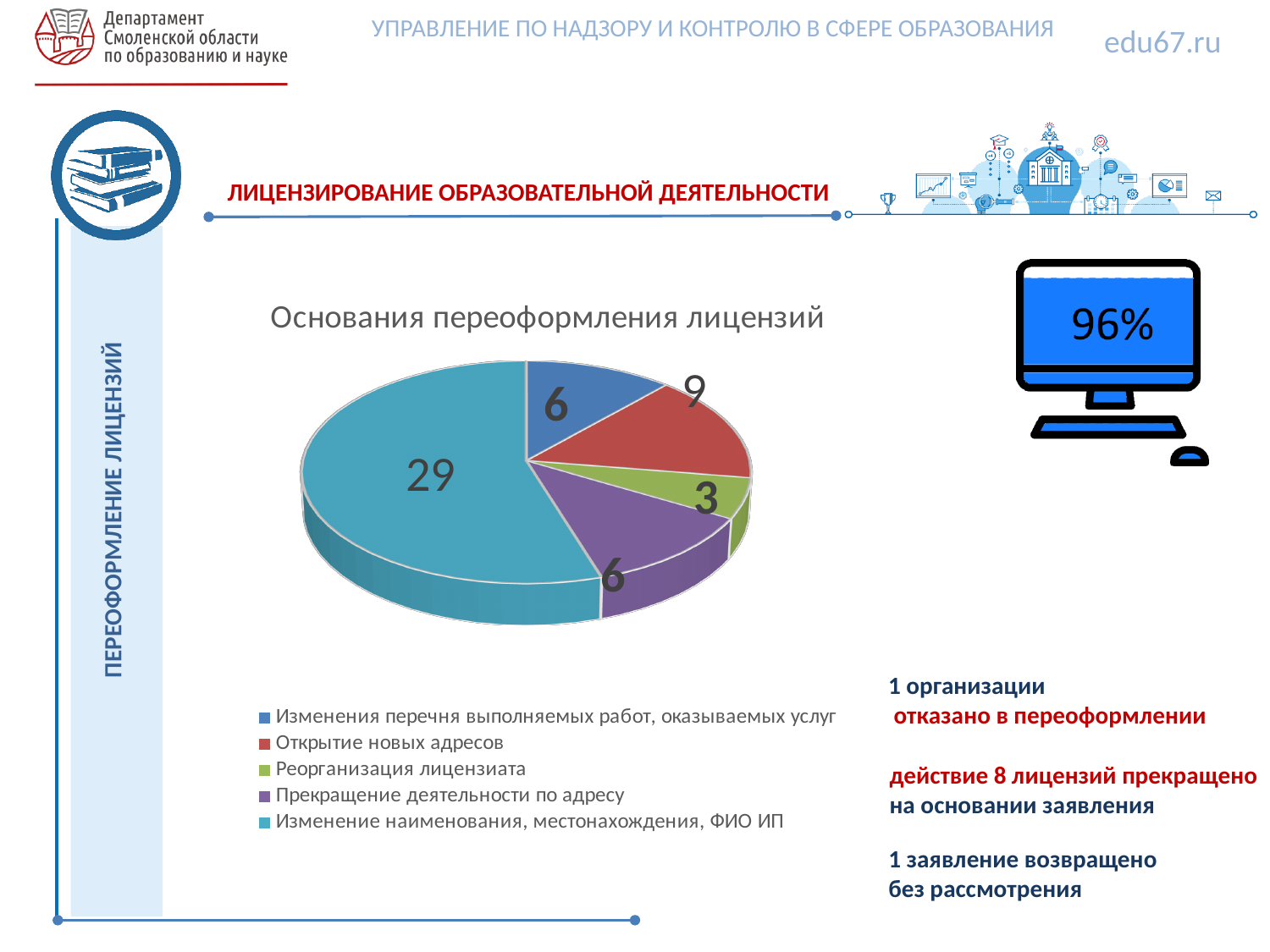
Which is larger: the value for "Открытие новых адресов" or the value for "Реорганизация лицензиата"? Открытие новых адресов Which category has the smallest slice of the pie? Реорганизация лицензиата What is the value for "Реорганизация лицензиата"? 3 What is the title of the chart? Основания переоформления лицензий What is the value for "Прекращение деятельности по адресу"? 6 What type of chart is shown on the slide? Pie chart What is the value for "Открытие новых адресов"? 9 How many categories does the pie chart have? 5 What is the total of all the values in the pie chart? 53 Which category has the largest slice of the pie? Изменение наименования, местонахождения, ФИО ИП What is the difference between the values for "Изменение наименования, местонахождения, ФИО ИП" and "Открытие новых адресов"? 20 What is the value for "Изменение наименования, местонахождения, ФИО ИП"? 29